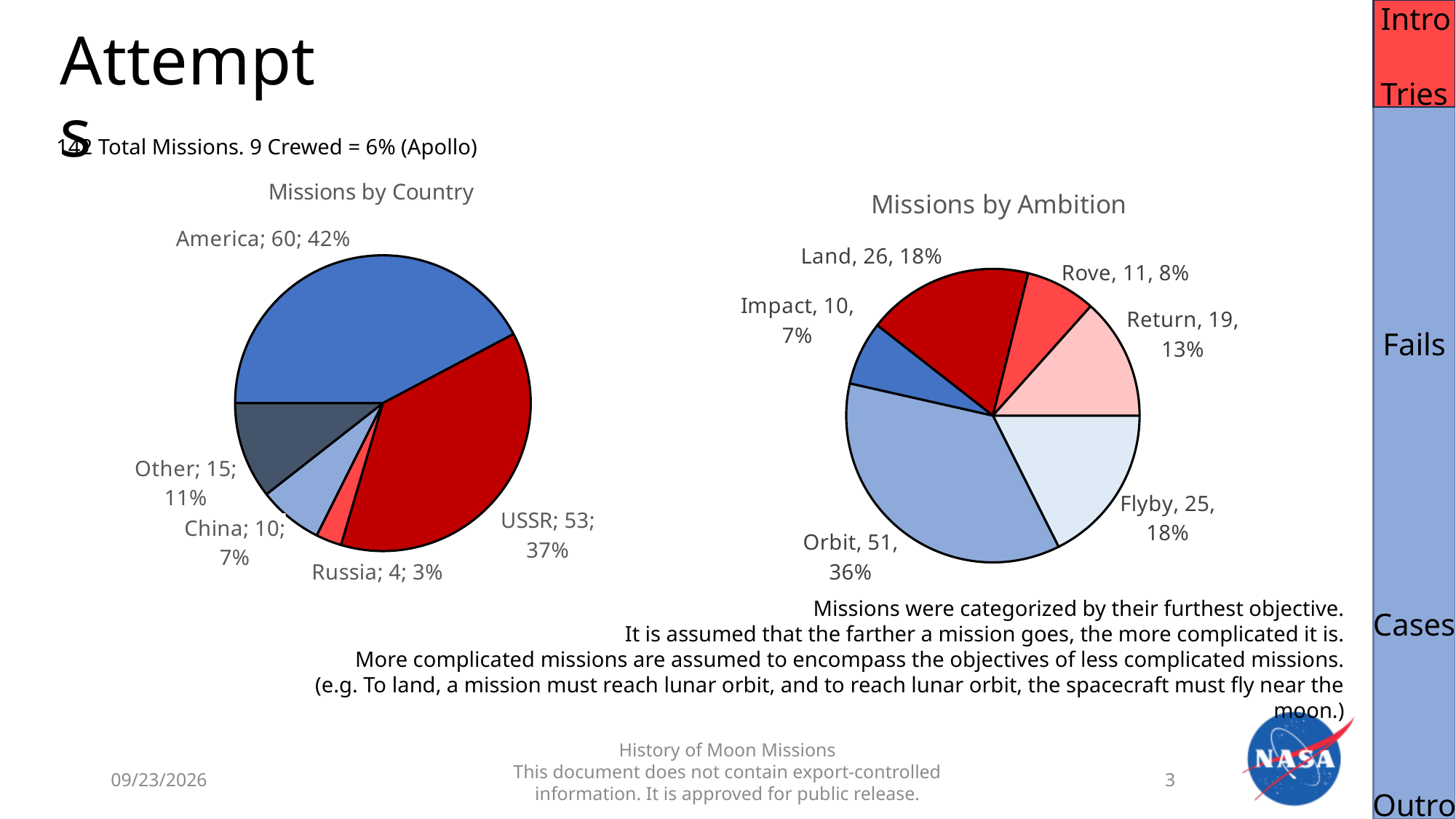
In the Missions by Country chart, what is the difference between the number of missions for America and the USSR? 7 In the Missions by Country chart, how many missions are attributed to America? 60 In the Missions by Ambition chart, which is larger, Land or Rove? Land In the Missions by Ambition chart, how many categories are shown? 6 In the Missions by Country chart, which country has the fewest missions? Russia In the Missions by Country chart, which category has the most missions? America In the Missions by Country chart, what share of missions does the USSR slice represent? 37% In the Missions by Ambition chart, how many missions are in the Orbit category? 51 In the Missions by Ambition chart, what percentage of missions are Return missions? 13% What type of chart is used for Missions by Ambition? Pie chart In the Missions by Country chart, how many categories are shown? 5 In the Missions by Ambition chart, which category has the smallest number of missions? Impact